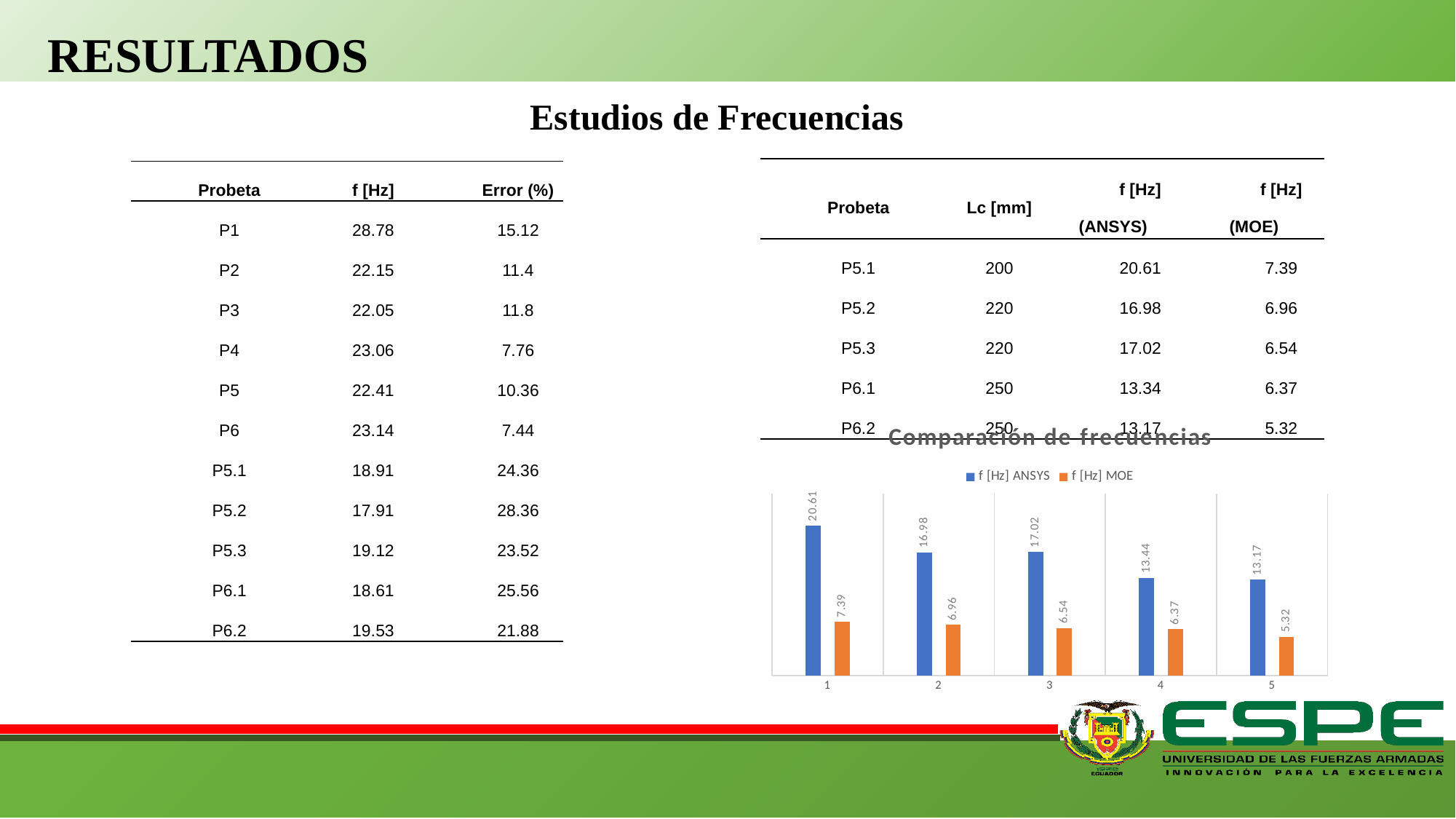
How many series does the chart legend list? 2 What is the f [Hz] MOE value for category 3 in the chart? 6.54 How many categories are shown on the x axis of the chart? 5 What type of chart is shown on the slide? bar chart Which category has the lowest f [Hz] MOE value in the chart? 5 What is the f [Hz] ANSYS value for category 1 in the chart? 20.61 In the chart, which is larger for category 4: the f [Hz] ANSYS value or the f [Hz] MOE value? f [Hz] ANSYS Which category has the highest f [Hz] ANSYS value in the chart? 1 What is the f [Hz] ANSYS value for category 5 in the chart? 13.17 Do the f [Hz] MOE values rise or fall from category 1 to category 5 in the chart? fall What is the difference between the f [Hz] ANSYS and f [Hz] MOE values for category 1 in the chart? 13.22 What is the title of the chart on the slide? Comparación de frecuencias